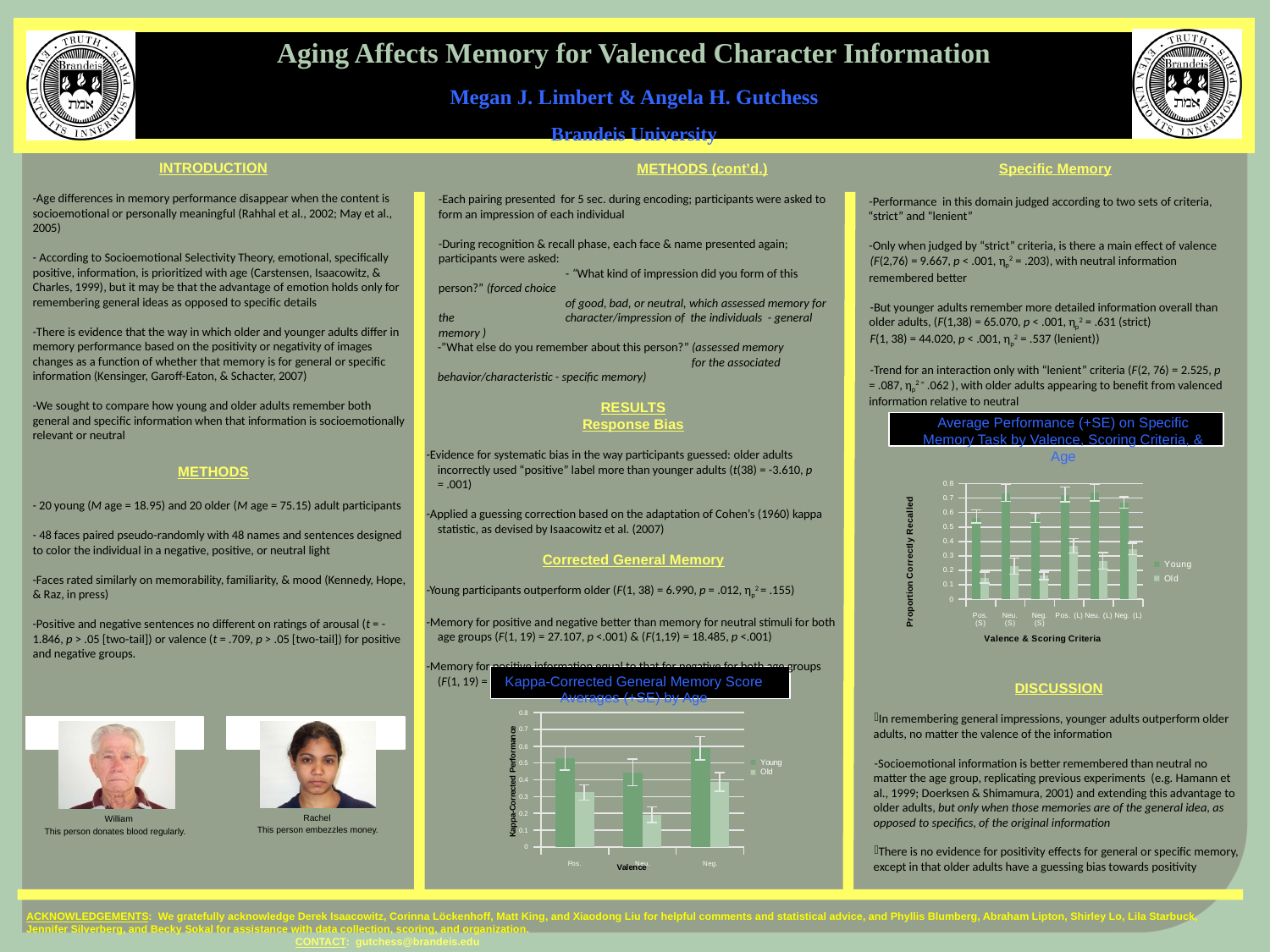
What is the y-axis label of the 'Average Performance (+SE) on Specific Memory Task' chart? Proportion Correctly Recalled In the 'Average Performance (+SE) on Specific Memory Task' chart, is the Old value for Pos. (S) greater or less than 0.2? less What kind of chart is the 'Kappa-Corrected General Memory Score Averages (+SE) by Age' chart? bar chart What kind of chart is the 'Average Performance (+SE) on Specific Memory Task by Valence, Scoring Criteria, & Age' chart? bar chart In the 'Kappa-Corrected General Memory Score Averages (+SE) by Age' chart, which category has the lowest Old value? Neu. In the 'Kappa-Corrected General Memory Score Averages (+SE) by Age' chart, which is larger for Neu.: the Young value or the Old value? Young How many categories are shown on the x axis of the 'Average Performance (+SE) on Specific Memory Task' chart? 6 How many series does the legend list in the 'Average Performance (+SE) on Specific Memory Task' chart? 2 How many categories are shown on the x axis of the 'Kappa-Corrected General Memory Score Averages (+SE) by Age' chart? 3 In the 'Kappa-Corrected General Memory Score Averages (+SE) by Age' chart, is the Young value for Neg. greater or less than 0.5? greater In the 'Average Performance (+SE) on Specific Memory Task' chart, which is larger for Neg. (S): the Young value or the Old value? Young In the 'Average Performance (+SE) on Specific Memory Task' chart, is the Young value for Neu. (S) greater or less than 0.6? greater